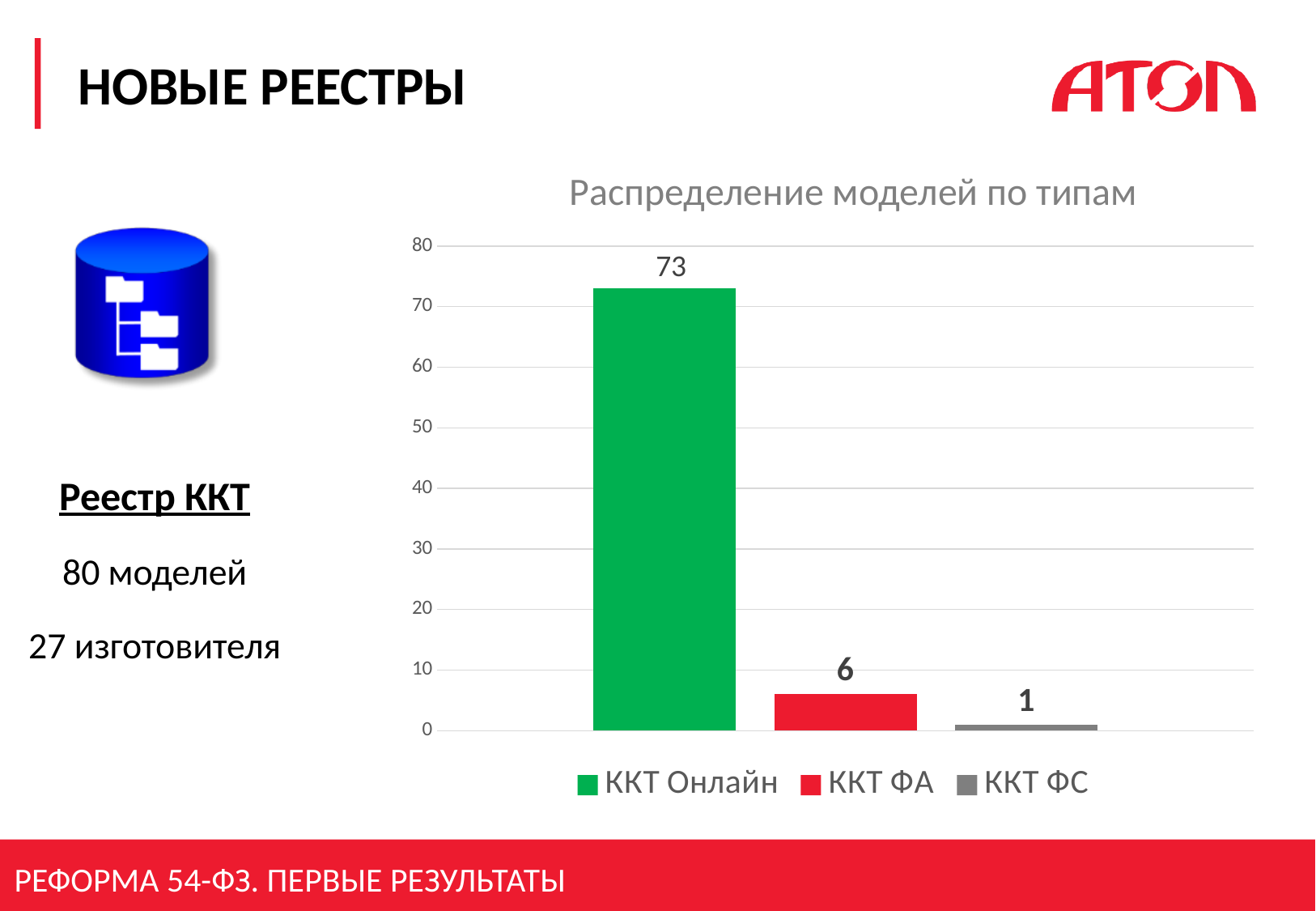
Which category has the highest value? ККТ Онлайн Which category has the lowest value? ККТ ФС What is the difference between the values for ККТ Онлайн and ККТ ФА? 67 What is the value for ККТ Онлайн? 73 What is the value for ККТ ФА? 6 Which is larger, the value for ККТ ФА or the value for ККТ ФС? ККТ ФА Is the value for ККТ Онлайн greater or less than 70? greater What is the value for ККТ ФС? 1 What is the title of the chart? Распределение моделей по типам What is the difference between the values for ККТ ФА and ККТ ФС? 5 How many bars are shown in the chart? 3 What kind of chart is shown on the slide? bar chart